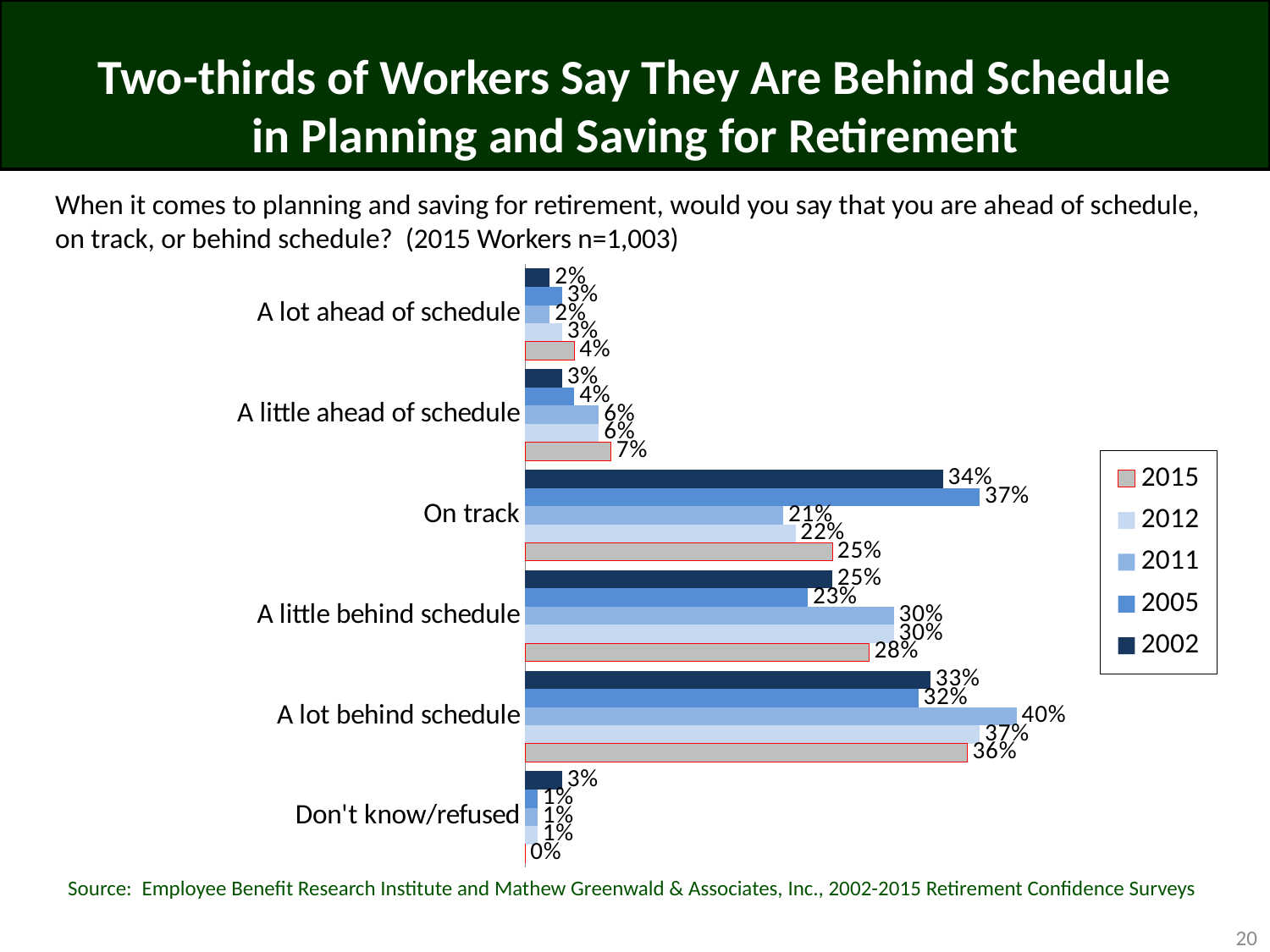
How many response categories are shown on the chart? 6 What type of chart is shown on the slide? bar chart How many series does the legend list? 5 Which is larger for "A little behind schedule": the 2002 value or the 2012 value? 2012 Which year has the highest value for "A lot behind schedule"? 2011 What is the difference between the 2005 and 2015 values for "On track"? 12% What is the 2005 value for "On track"? 37% What is the 2015 value for "A lot behind schedule"? 36% Which response category has the highest 2015 value? A lot behind schedule What is the 2015 value for "Don't know/refused"? 0% What is the 2011 value for "A little behind schedule"? 30% Which series in the legend is drawn in gray with a red outline? 2015